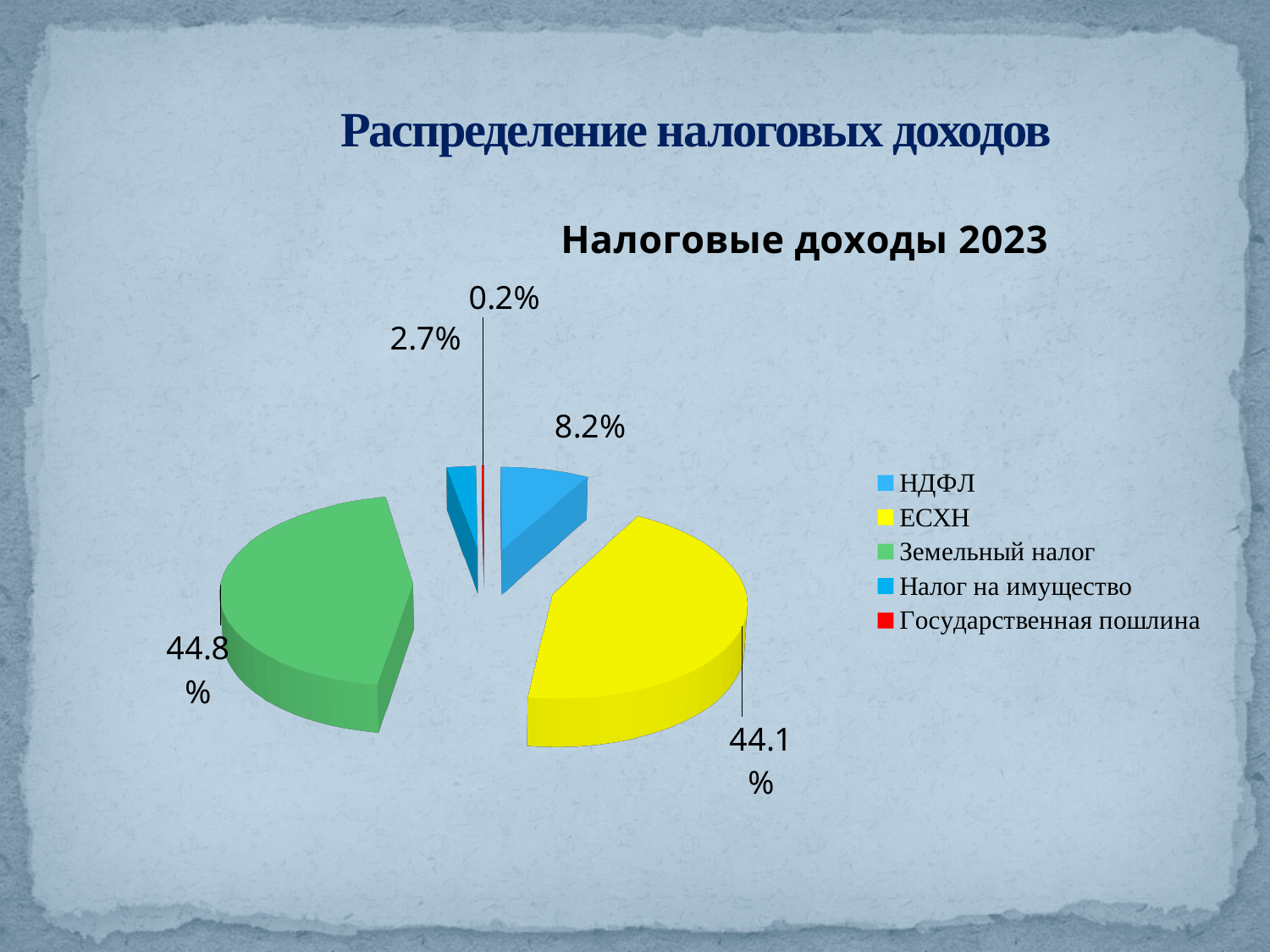
What share of tax revenue does Налог на имущество account for? 2.7% What is the difference in percentage points between the shares of Земельный налог and ЕСХН? 0.7 What type of chart is shown on the slide? Pie chart What is the title of the chart? Налоговые доходы 2023 What share of tax revenue does Государственная пошлина account for? 0.2% What share of tax revenue does НДФЛ account for? 8.2% Which category has the largest share of tax revenue? Земельный налог How many categories does the legend of the pie chart list? 5 What share of tax revenue does Земельный налог account for? 44.8% Which category has the smallest share of tax revenue? Государственная пошлина What share of tax revenue does ЕСХН account for? 44.1% Which is larger: the share of НДФЛ or the share of Налог на имущество? НДФЛ